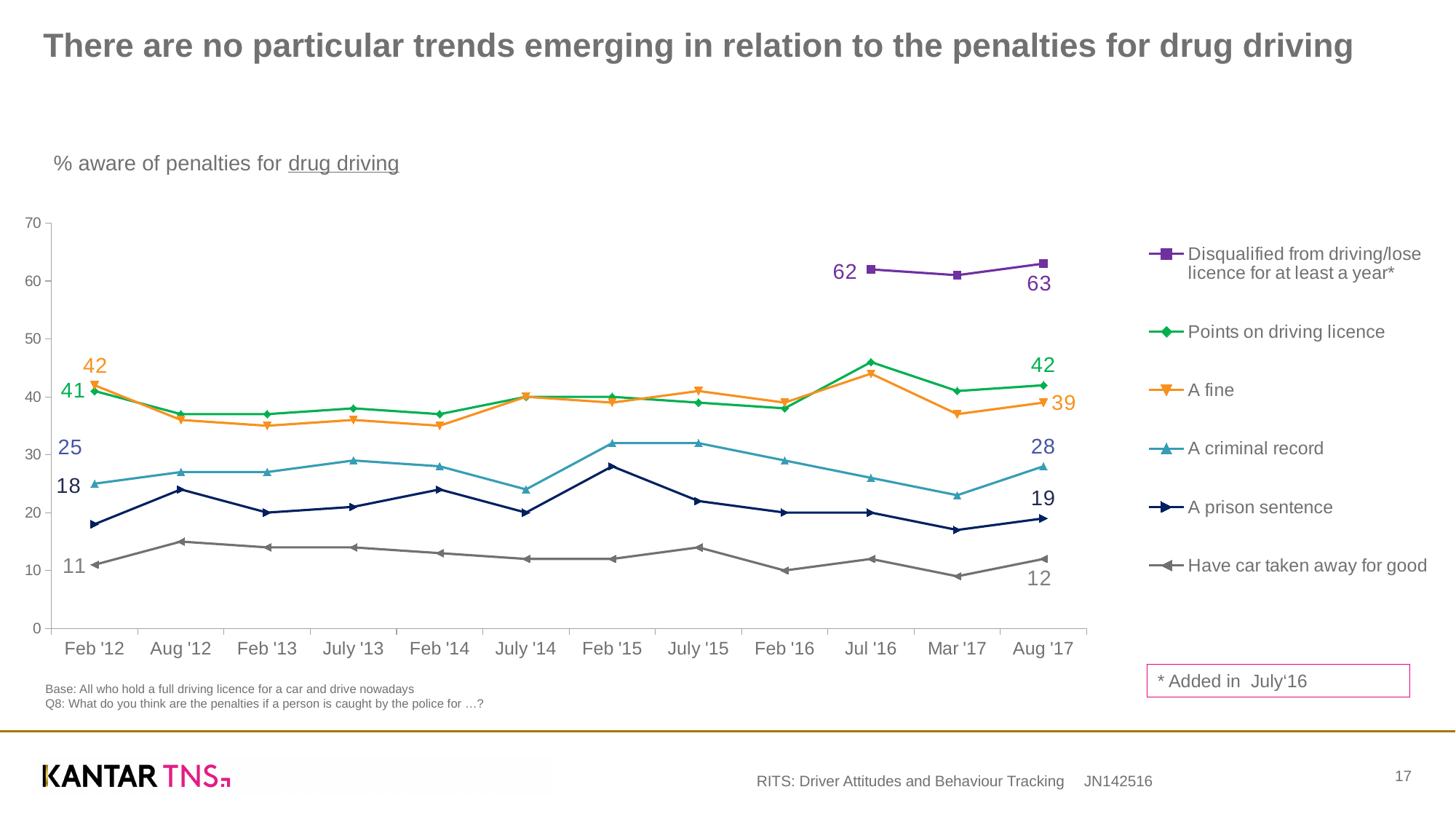
Is the value for 'A fine' in July '15 greater or less than 30? greater Which is larger in Aug '17: 'A fine' or 'A criminal record'? A fine What type of chart is shown on the slide? line chart What is the value for 'Disqualified from driving/lose licence for at least a year*' in Jul '16? 62 How many series does the legend list? 6 What is the value for 'Points on driving licence' in Aug '17? 42 Which series has the highest value in Aug '17? Disqualified from driving/lose licence for at least a year* What is the value for 'A prison sentence' in Aug '17? 19 What is the difference between 'A criminal record' in Aug '17 and in Feb '12? 3 Which series has the lowest value in Feb '12? Have car taken away for good What is the value for 'A fine' in Feb '12? 42 How many time points are shown on the x axis? 12